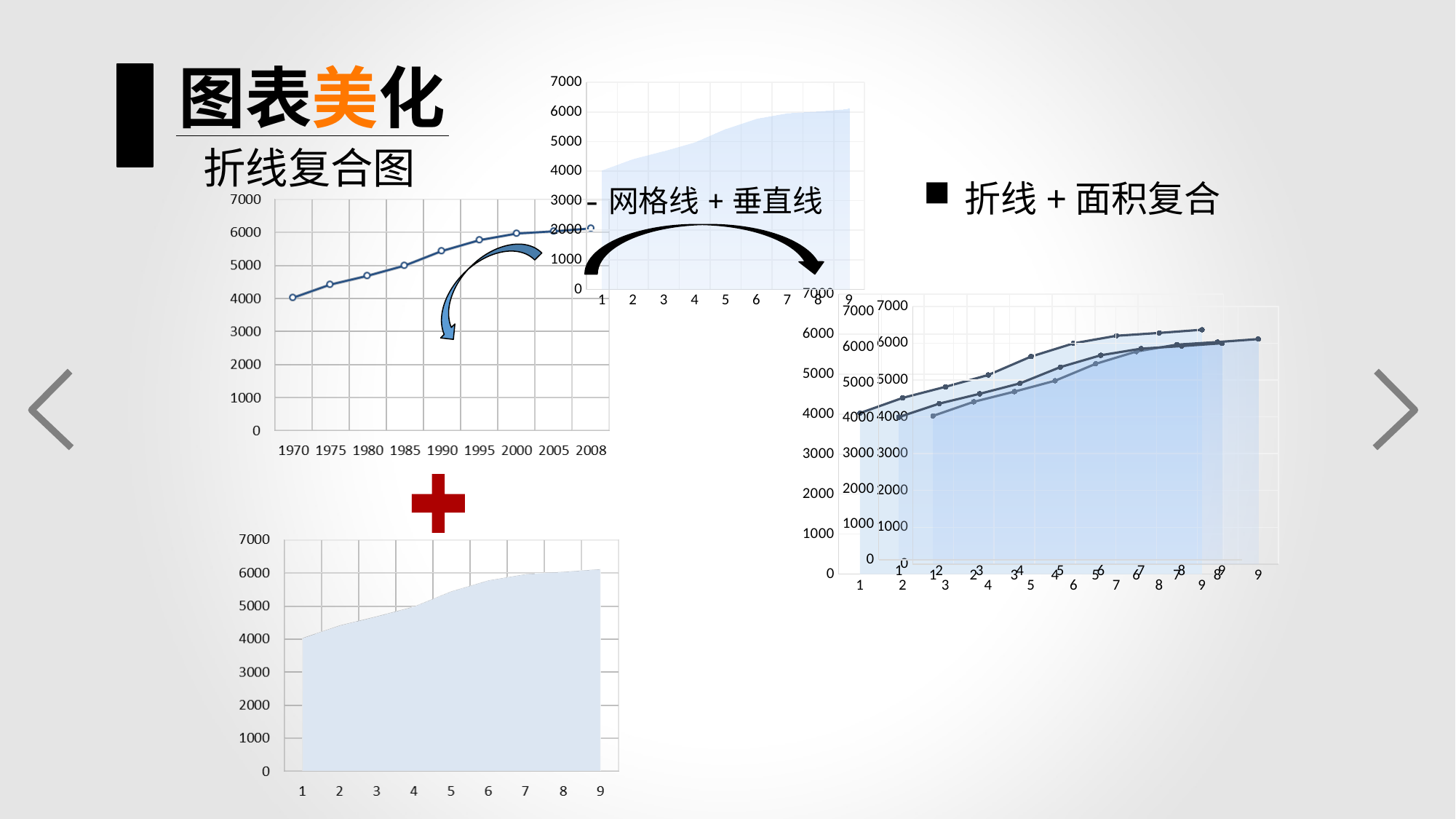
In the top-left line chart, is the value for 1975 greater or less than 5000? less What kind of chart is the bottom-left chart with categories 1 to 9? area chart In the top-left line chart, do the values rise or fall from 1970 to 2008? rise In the top-left line chart, which year has the lowest value? 1970 In the bottom-left area chart, is the value for category 9 greater or less than 5000? greater In the top-left line chart, is the value for 1990 greater or less than 5000? greater In the top-left line chart, how many data points are plotted? 9 In the bottom-left area chart, how many categories are on the x axis? 9 In the bottom-left area chart, do the values rise or fall from category 1 to category 9? rise What kind of chart is the top-left chart with years on the x axis? line chart